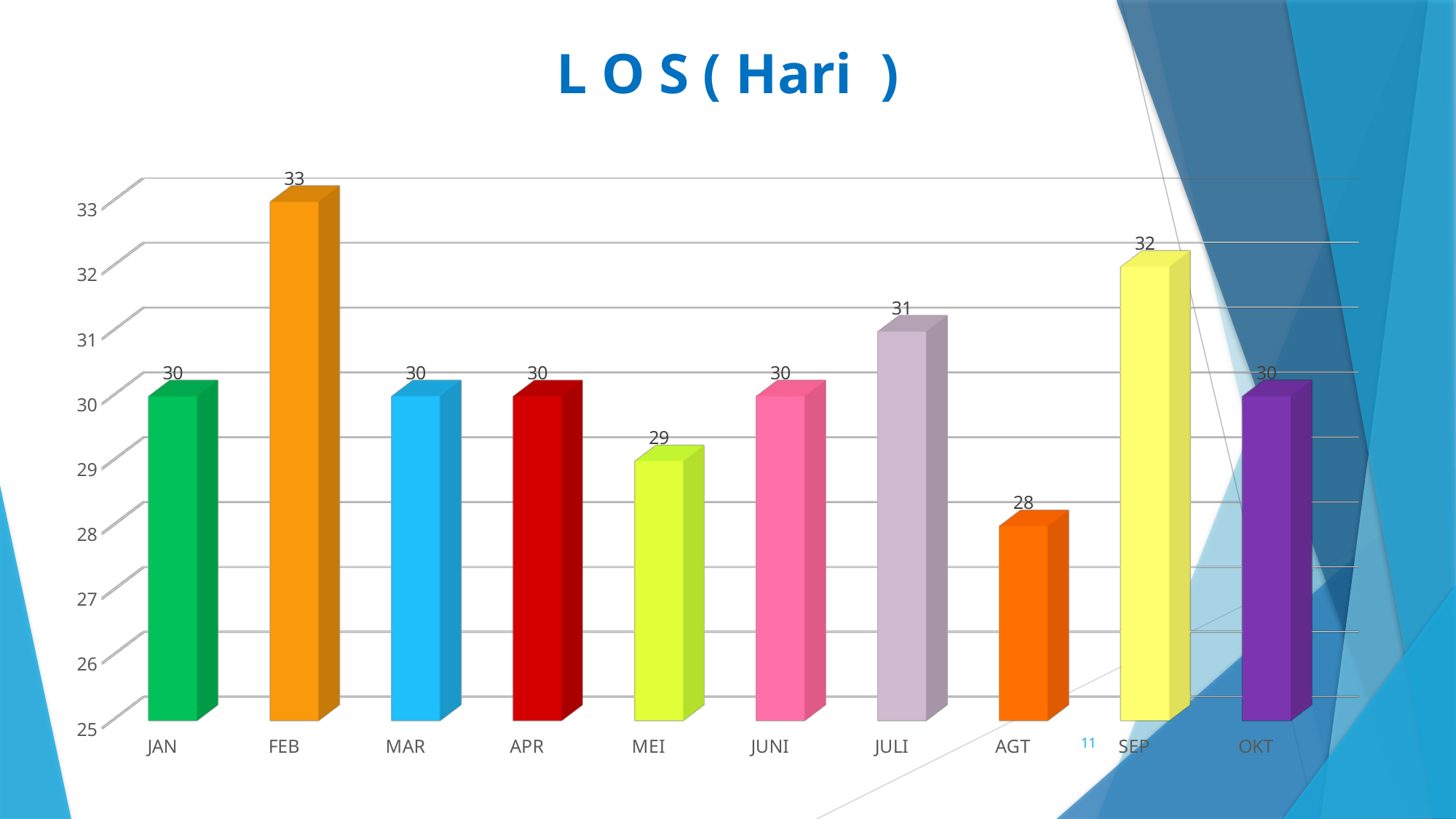
What is the title of the chart? L O S ( Hari ) What is the value for AGT? 28 Which is larger, the value for JULI or the value for SEP? SEP Which month has the highest value? FEB What is the difference between the values for FEB and AGT? 5 How many months have a value of 30? 5 How many months are shown on the x axis? 10 What kind of chart is shown on the slide? Bar chart Which month has the lowest value? AGT What is the value for FEB? 33 What is the value for MEI? 29 What is the value for SEP? 32